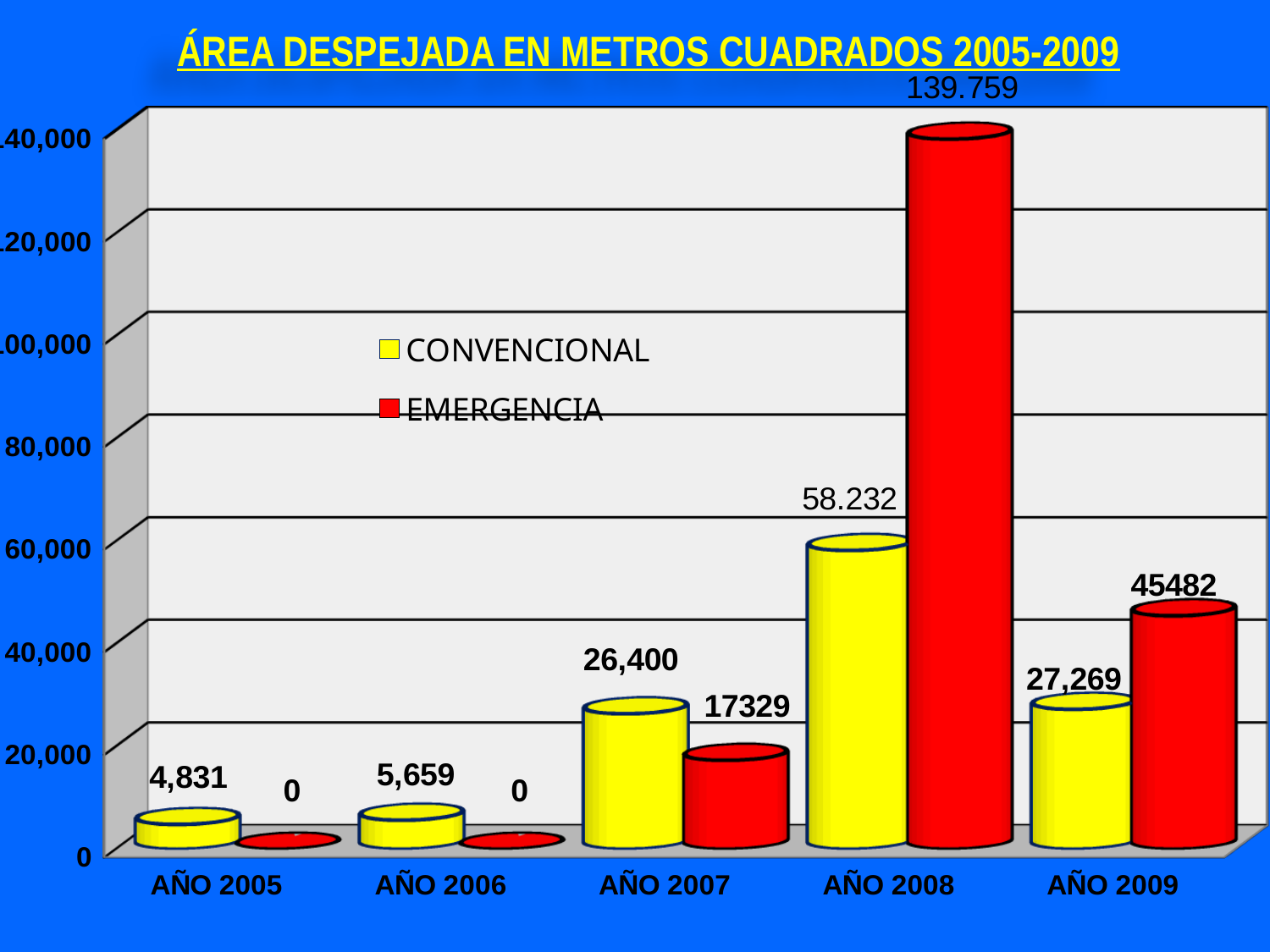
What is the difference between the CONVENCIONAL values for AÑO 2006 and AÑO 2005? 828 How many years are shown on the x axis? 5 Which is larger in AÑO 2009, CONVENCIONAL or EMERGENCIA? EMERGENCIA How many series does the legend list? 2 What is the value for EMERGENCIA in AÑO 2009? 45482 What is the value for CONVENCIONAL in AÑO 2005? 4,831 What is the value for EMERGENCIA in AÑO 2008? 139.759 What is the value for EMERGENCIA in AÑO 2006? 0 What type of chart is shown on the slide? Bar chart What is the value for CONVENCIONAL in AÑO 2007? 26,400 In which year is the CONVENCIONAL value highest? AÑO 2008 In which year is the CONVENCIONAL value lowest? AÑO 2005